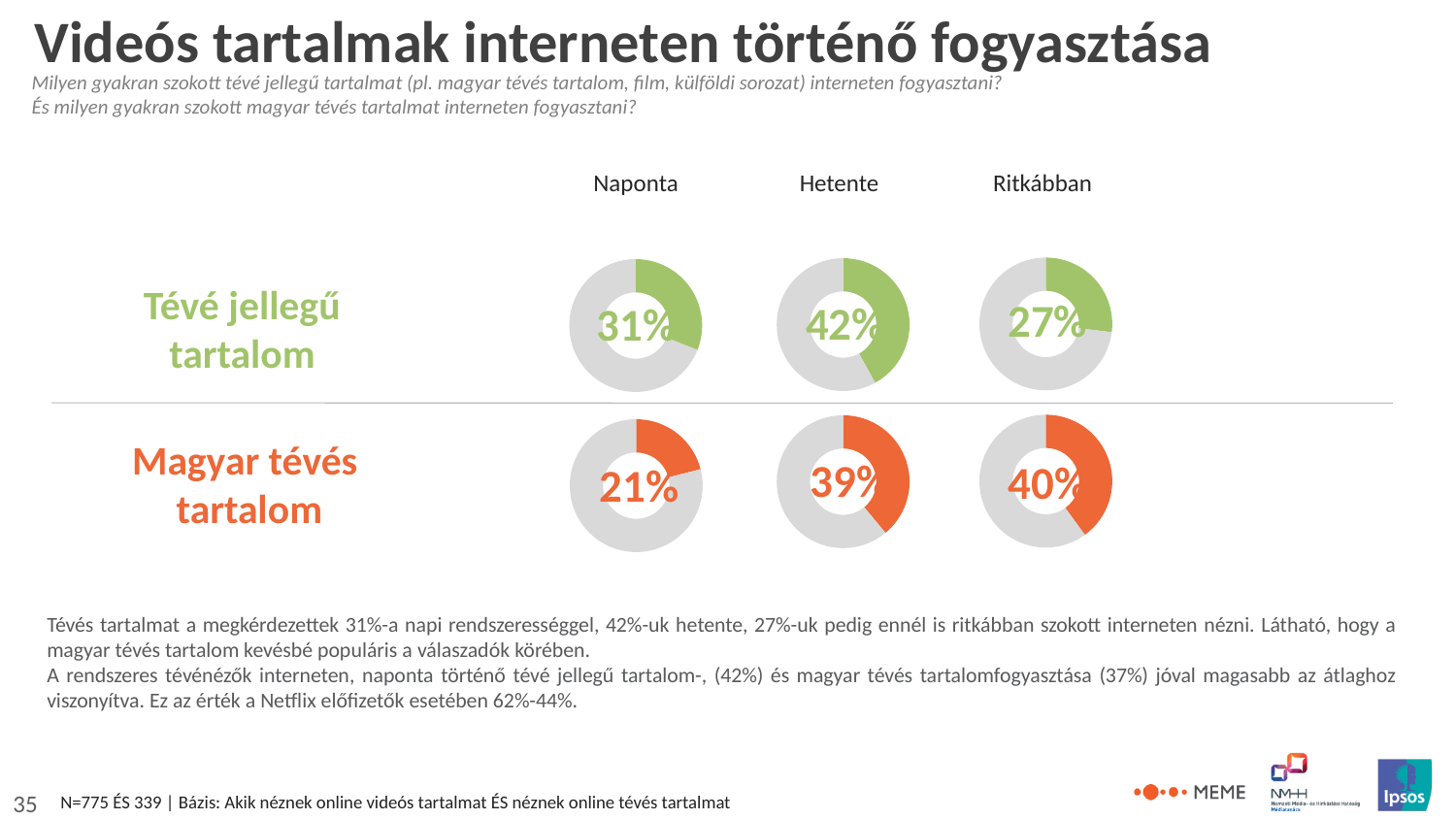
What type of chart is used to display the percentages on the slide? Donut (pie) chart In the Magyar tévés tartalom row, which column (Naponta, Hetente or Ritkábban) has the lowest percentage? Naponta In the Tévé jellegű tartalom row, which column (Naponta, Hetente or Ritkábban) has the highest percentage? Hetente What percentage is shown in the donut chart for Magyar tévés tartalom under Naponta? 21% What percentage is shown in the donut chart for Magyar tévés tartalom under Ritkábban? 40% What is the difference between the Hetente and Ritkábban percentages for Tévé jellegű tartalom? 15 percentage points What percentage is shown in the donut chart for Tévé jellegű tartalom under Naponta? 31% Which is larger: the Ritkábban value for Tévé jellegű tartalom or the Ritkábban value for Magyar tévés tartalom? Magyar tévés tartalom What is the difference between the Naponta percentages for Tévé jellegű tartalom and Magyar tévés tartalom? 10 percentage points What percentage is shown in the donut chart for Tévé jellegű tartalom under Hetente? 42% What colour are the filled segments in the Magyar tévés tartalom row of donut charts? Orange How many donut charts are shown on the slide? 6